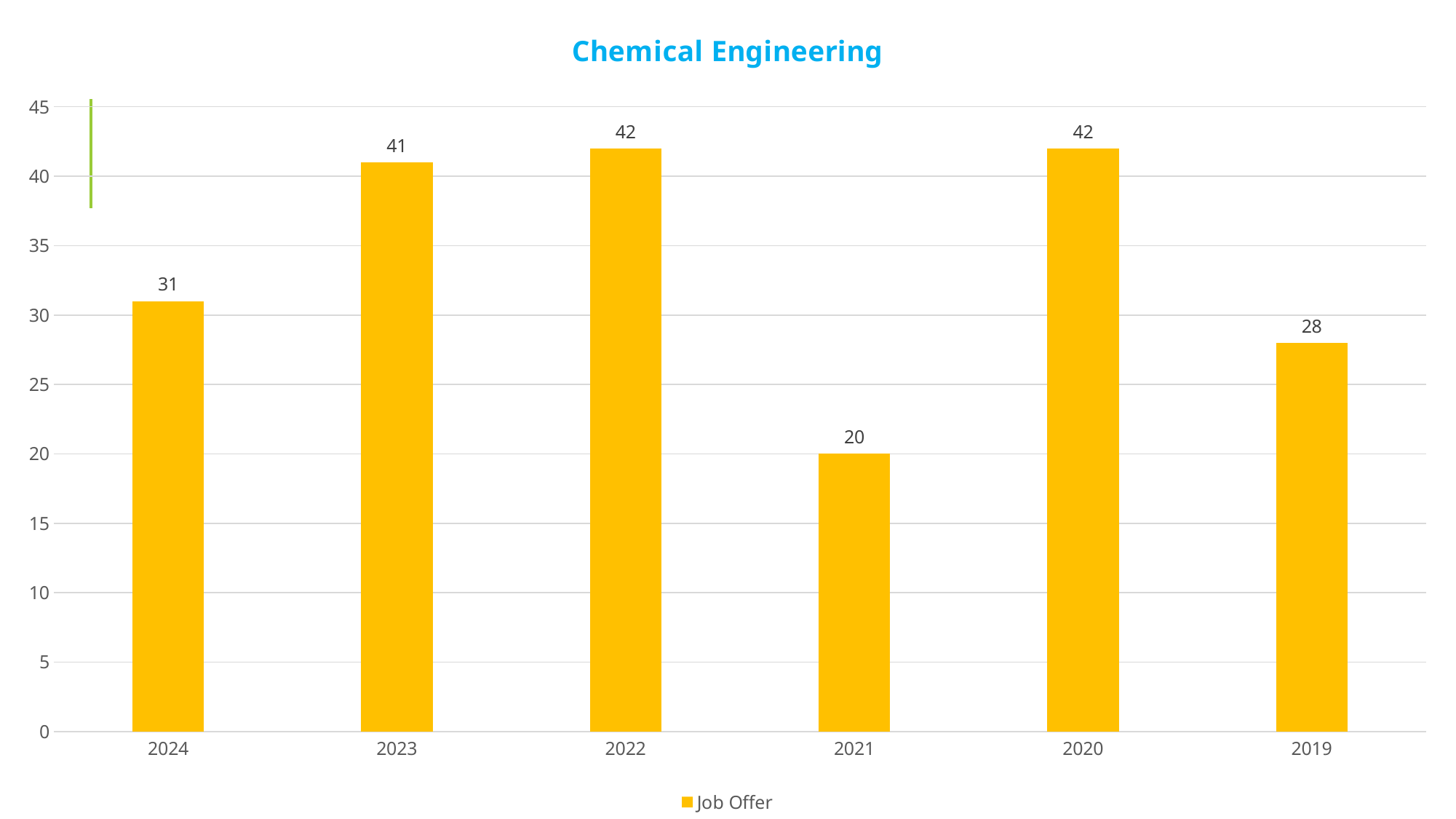
Which year has the lowest Job Offer value? 2021 What is the difference between the Job Offer values for 2022 and 2021? 22 What kind of chart is shown? Bar chart How many years are shown on the x axis? 6 What is the difference between the Job Offer values for 2024 and 2019? 3 Which is larger, the Job Offer value for 2023 or for 2019? 2023 What is the Job Offer value for 2019? 28 What is the Job Offer value for 2024? 31 What is the title of the chart? Chemical Engineering How many series does the legend list? 1 What is the Job Offer value for 2021? 20 What is the Job Offer value for 2023? 41